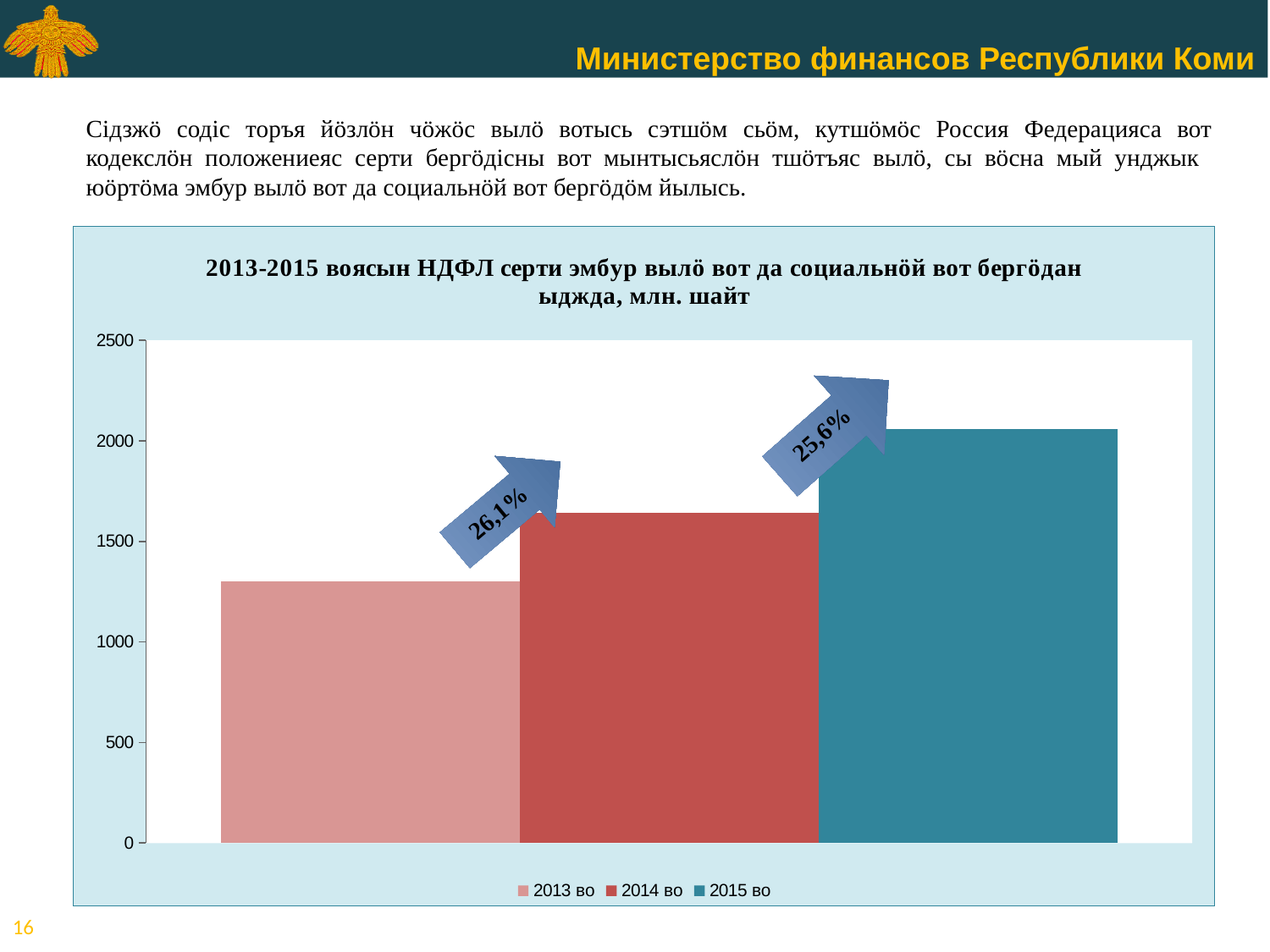
Which year has the lowest bar? 2013 во How many entries does the legend list? 3 Which year has the highest bar? 2015 во Is the value for 2014 во greater or less than 1500? greater What percentage is printed on the arrow between the 2014 and 2015 bars? 25,6% Is the value for 2015 во greater or less than 2000? greater Do the values rise or fall from 2013 to 2015? rise What percentage is printed on the arrow between the 2013 and 2014 bars? 26,1% What kind of chart is shown on the slide? bar chart Is the value for 2013 во greater or less than 1500? less How many bars are plotted in the chart? 3 Which is larger, the value for 2014 во or the value for 2015 во? 2015 во